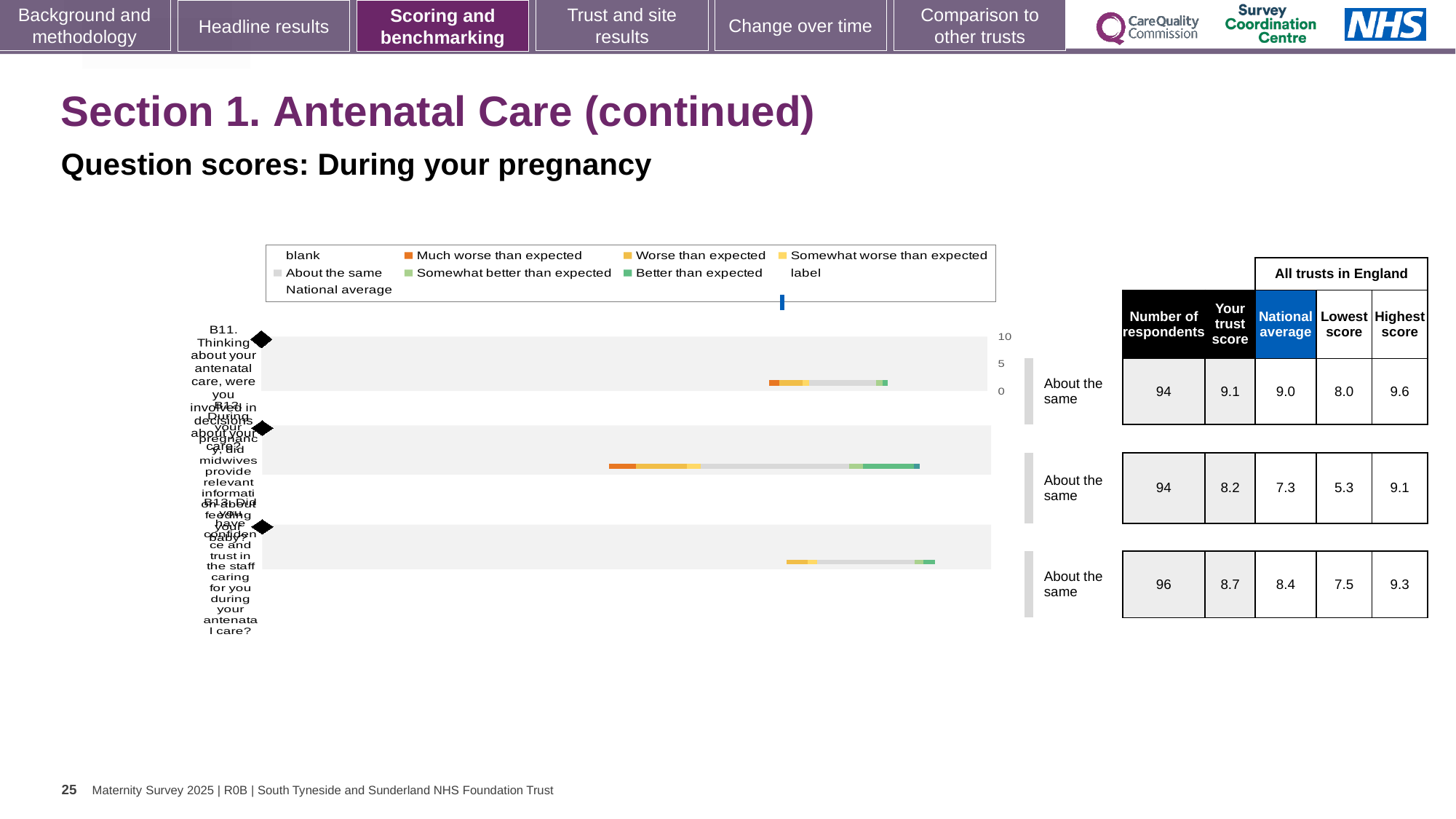
For question B12, what is the difference between the highest score and the lowest score across all trusts in England? 3.8 Which question has the lowest national average? B12 What is the difference between the trust score and the national average for question B11? 0.1 For question B13, which is larger: the trust score or the national average? the trust score (8.7) How many respondents are listed for question B13 (confidence and trust in the staff)? 96 Which question has the highest 'Your trust score'? B11 What kind of chart is shown on the slide? bar chart How many questions (bars) are plotted in the chart? 3 What is the 'Your trust score' for question B11 (involved in decisions about your care)? 9.1 What is the national average for question B12 (midwives provide relevant information about feeding your baby)? 7.3 What colour does the legend use for 'Much worse than expected'? orange What benchmark category is shown for question B11? About the same